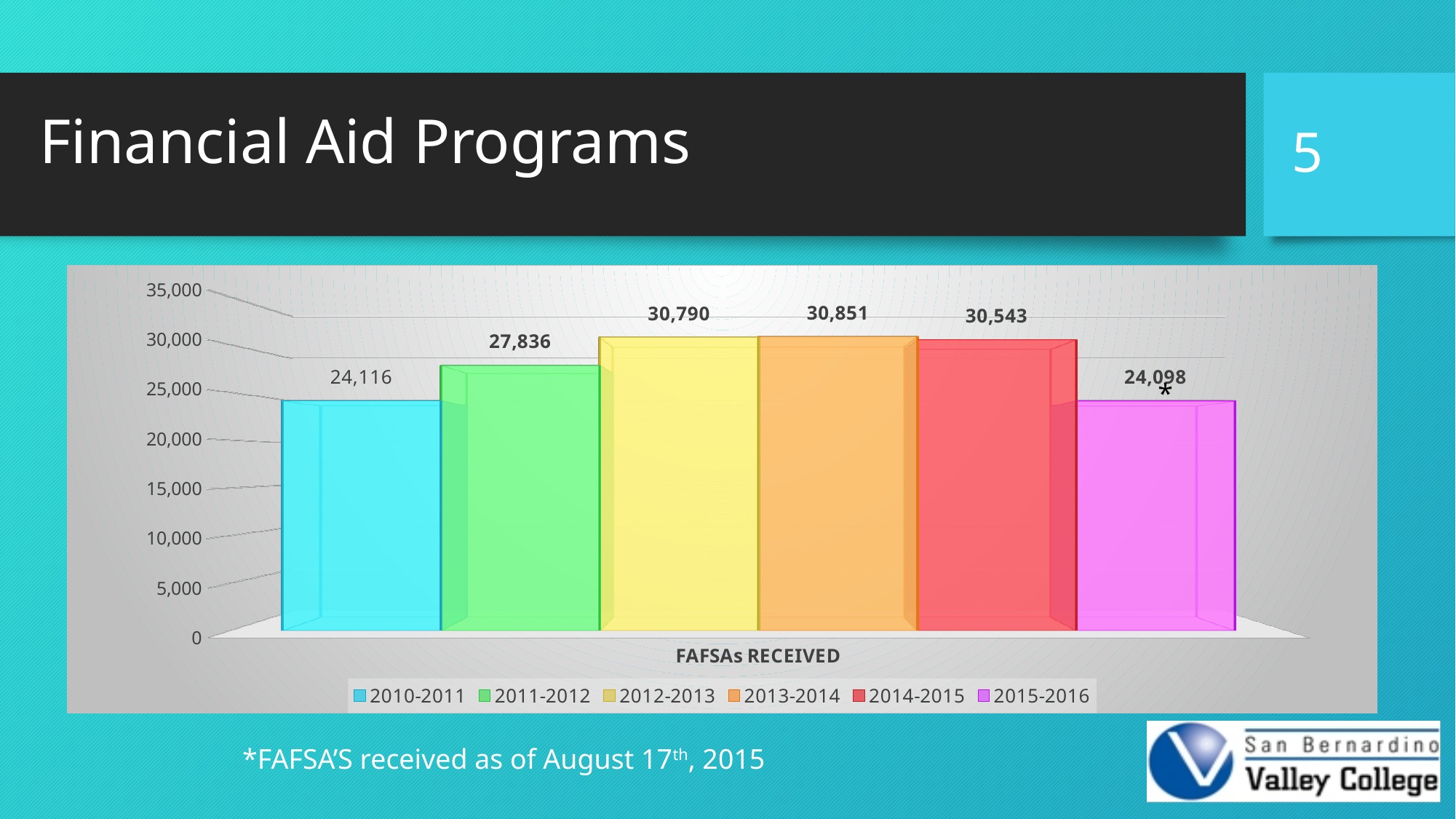
Which year has the lowest number of FAFSAs received? 2015-2016 What is the value shown for 2015-2016? 24,098 What kind of chart is shown on the slide? bar chart How many FAFSAs were received in 2010-2011? 24,116 What is the value shown for 2013-2014? 30,851 How many bars are plotted in the chart? 6 Which year has the highest number of FAFSAs received? 2013-2014 Which is larger, the value for 2012-2013 or the value for 2011-2012? 2012-2013 Is the value for 2010-2011 greater or less than 25,000? less What is the difference between the 2013-2014 and 2014-2015 values? 308 How many series does the legend list? 6 What is the difference between the 2011-2012 and 2010-2011 values? 3,720